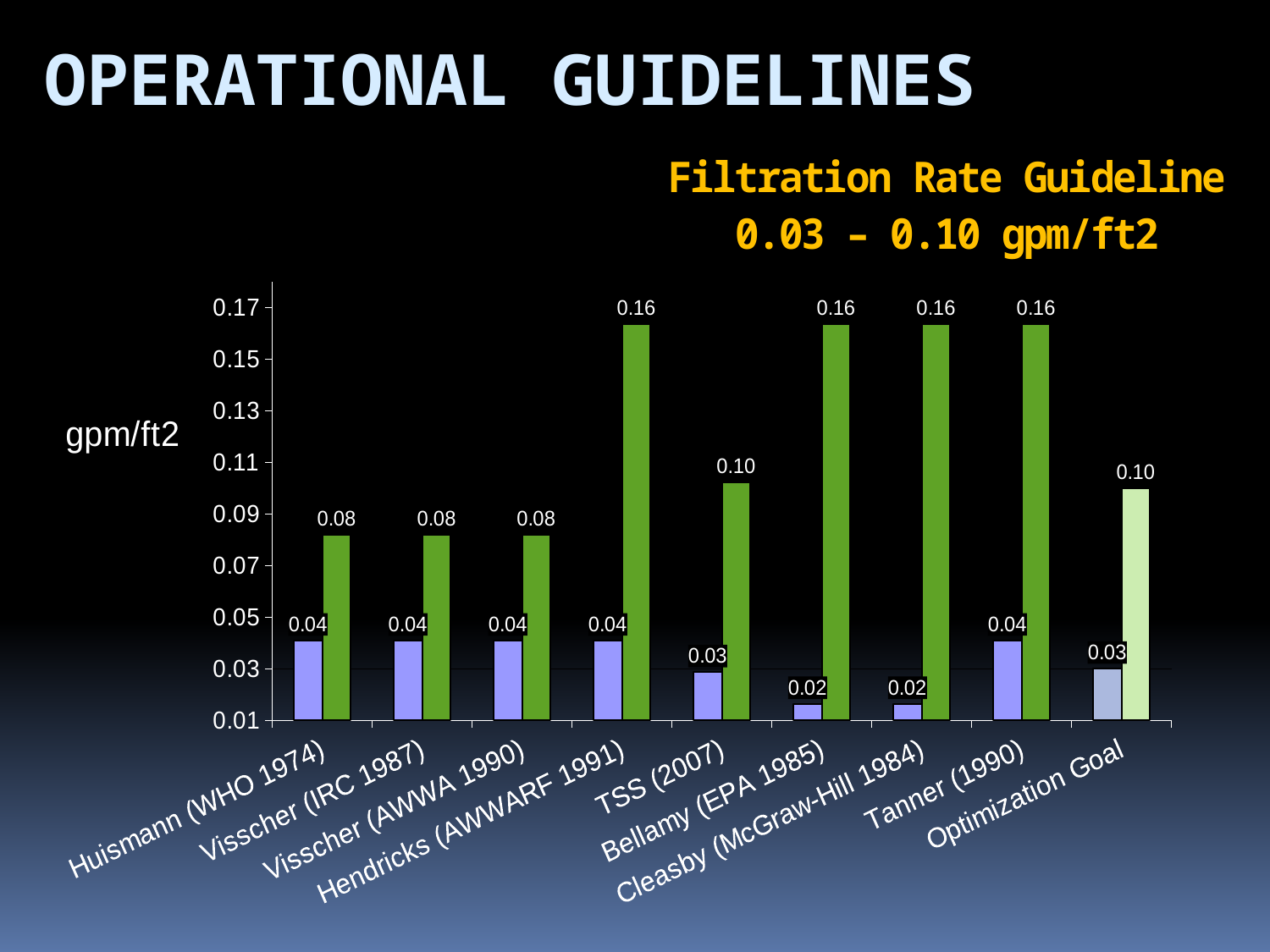
What is the difference between the taller bar for TSS (2007) and the taller bar for Visscher (IRC 1987)? 0.02 What filtration rate guideline range is stated above the chart? 0.03 – 0.10 gpm/ft2 What is the value of the blue (shorter) bar for TSS (2007)? 0.03 What is the value of the shorter bar for Bellamy (EPA 1985)? 0.02 How many categories are shown along the x axis of the chart? 9 What is the value of the green (taller) bar for Hendricks (AWWARF 1991)? 0.16 What is the difference between the two bars for Hendricks (AWWARF 1991)? 0.12 What unit label is shown on the y axis of the chart? gpm/ft2 What type of chart is shown on the slide? bar chart Which is larger: the green bar for Huismann (WHO 1974) or the green bar for Tanner (1990)? Tanner (1990) What is the value of the taller bar for Optimization Goal? 0.10 What is the value of the green (taller) bar for Huismann (WHO 1974)? 0.08